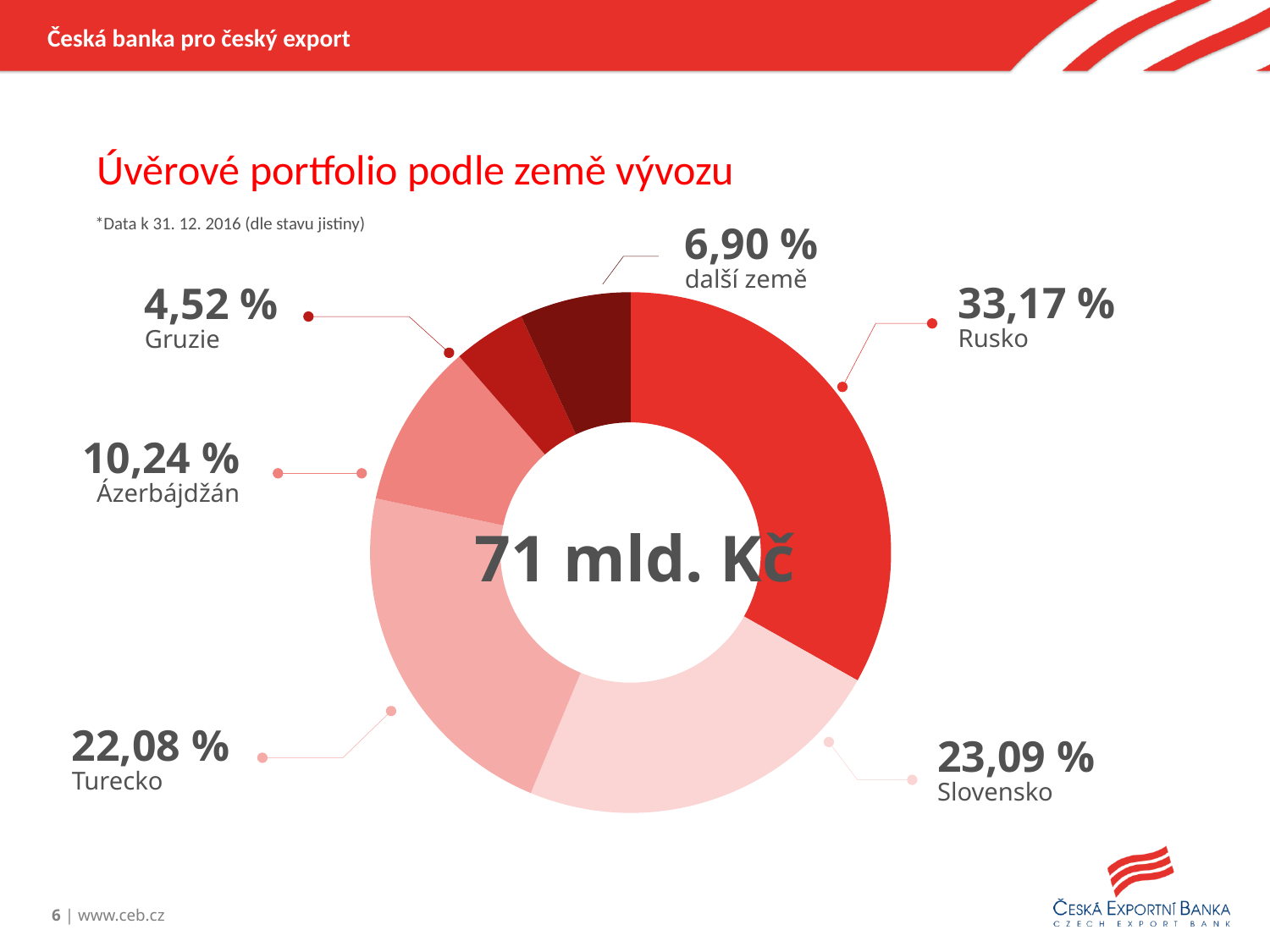
Which labelled category has the smallest share? Gruzie What share is labelled for Ázerbájdžán? 10,24 % What share of the credit portfolio does Rusko account for? 33,17 % What percentage is shown for Gruzie? 4,52 % Which country has the largest share of the portfolio? Rusko What is the difference in percentage points between Rusko and Slovensko? 10,08 What percentage is shown for Slovensko? 23,09 % What kind of chart is shown on the slide? Pie (donut) chart What percentage is shown for Turecko? 22,08 % What total value is printed in the centre of the chart? 71 mld. Kč What share is labelled for 'další země'? 6,90 % Which has a larger share, Slovensko or Turecko? Slovensko